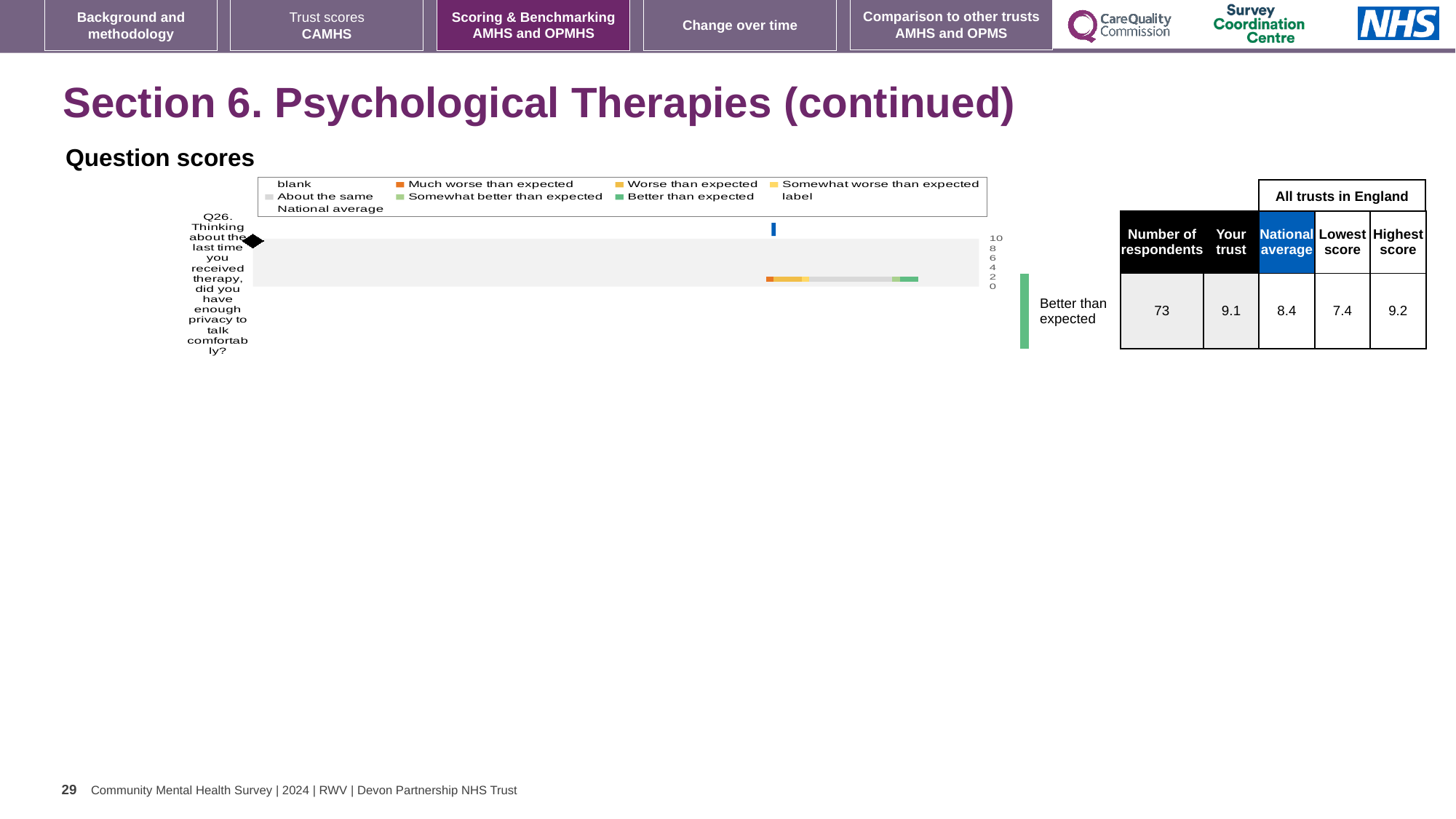
Is the 'Your trust' score for Q26 larger or smaller than the national average? larger In the table next to the chart, what is the 'Your trust' score for Q26? 9.1 How many questions (categories) are plotted in the Question scores chart? 1 What kind of chart is shown under 'Question scores'? bar chart In the table next to the chart, what is the national average score for Q26? 8.4 Which question is plotted in the Question scores chart? Q26. Thinking about the last time you received therapy, did you have enough privacy to talk comfortably? What benchmark category label is shown to the right of the Q26 bar? Better than expected What is the difference between the 'Your trust' score and the national average for Q26? 0.7 In the table next to the chart, what is the lowest score among all trusts in England for Q26? 7.4 What is the highest tick value shown on the chart's axis? 10 In the table next to the chart, what is the number of respondents for Q26? 73 In the table next to the chart, what is the highest score among all trusts in England for Q26? 9.2